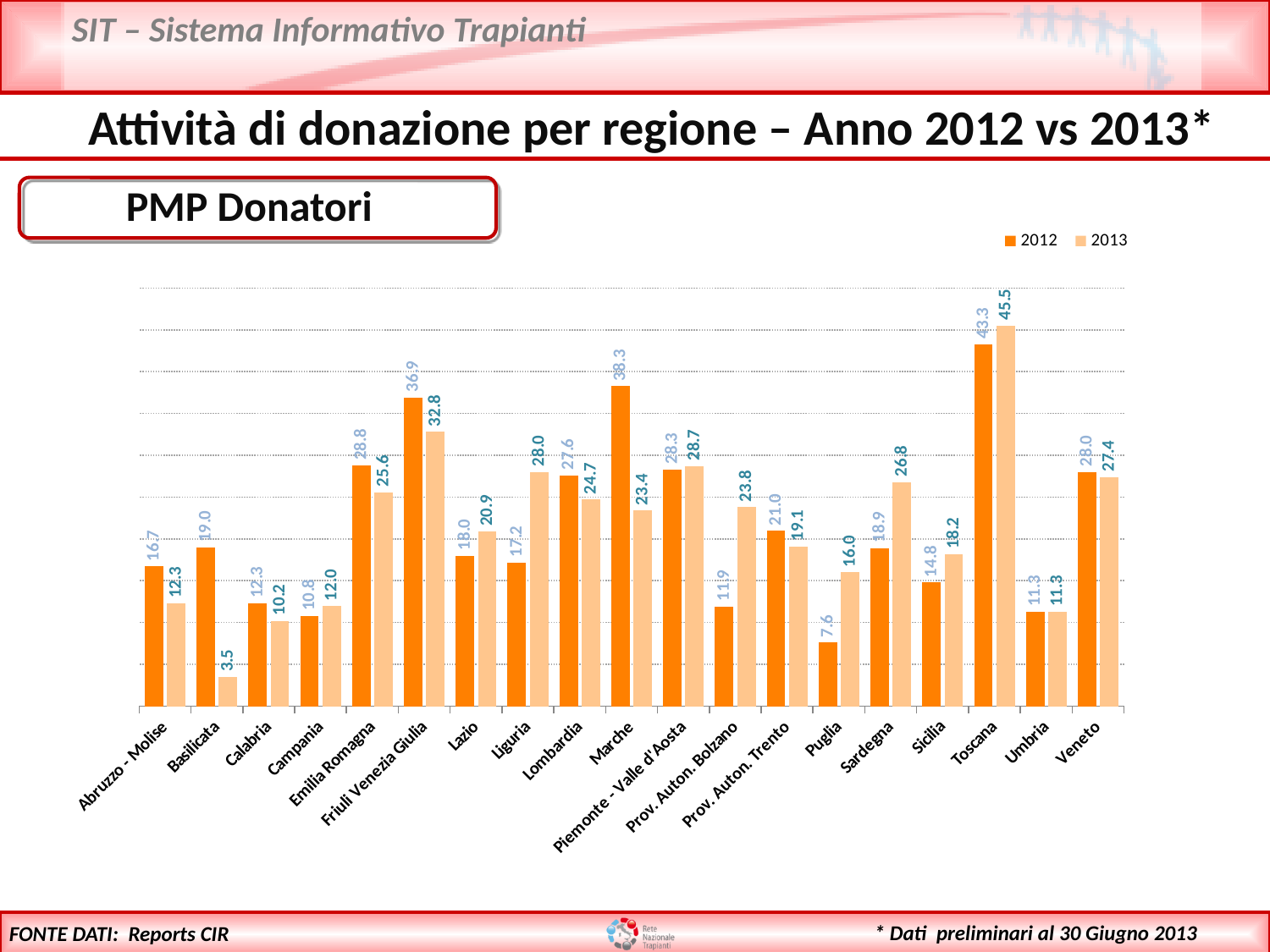
Which region has the highest 2012 value? Toscana What is the difference between the 2012 and 2013 values for Marche? 14.9 How many regions are shown on the x axis? 19 What is the 2012 PMP Donatori value for Marche? 38.3 Which region has the lowest 2012 value? Puglia What is the 2013 value for Basilicata? 3.5 What is the 2013 PMP Donatori value for Toscana? 45.5 Which region has the lowest 2013 value? Basilicata Which is larger for Liguria, the 2012 value or the 2013 value? 2013 What kind of chart is shown on the slide? Bar chart How many series does the legend list? 2 Which is larger for Friuli Venezia Giulia, the 2012 value or the 2013 value? 2012